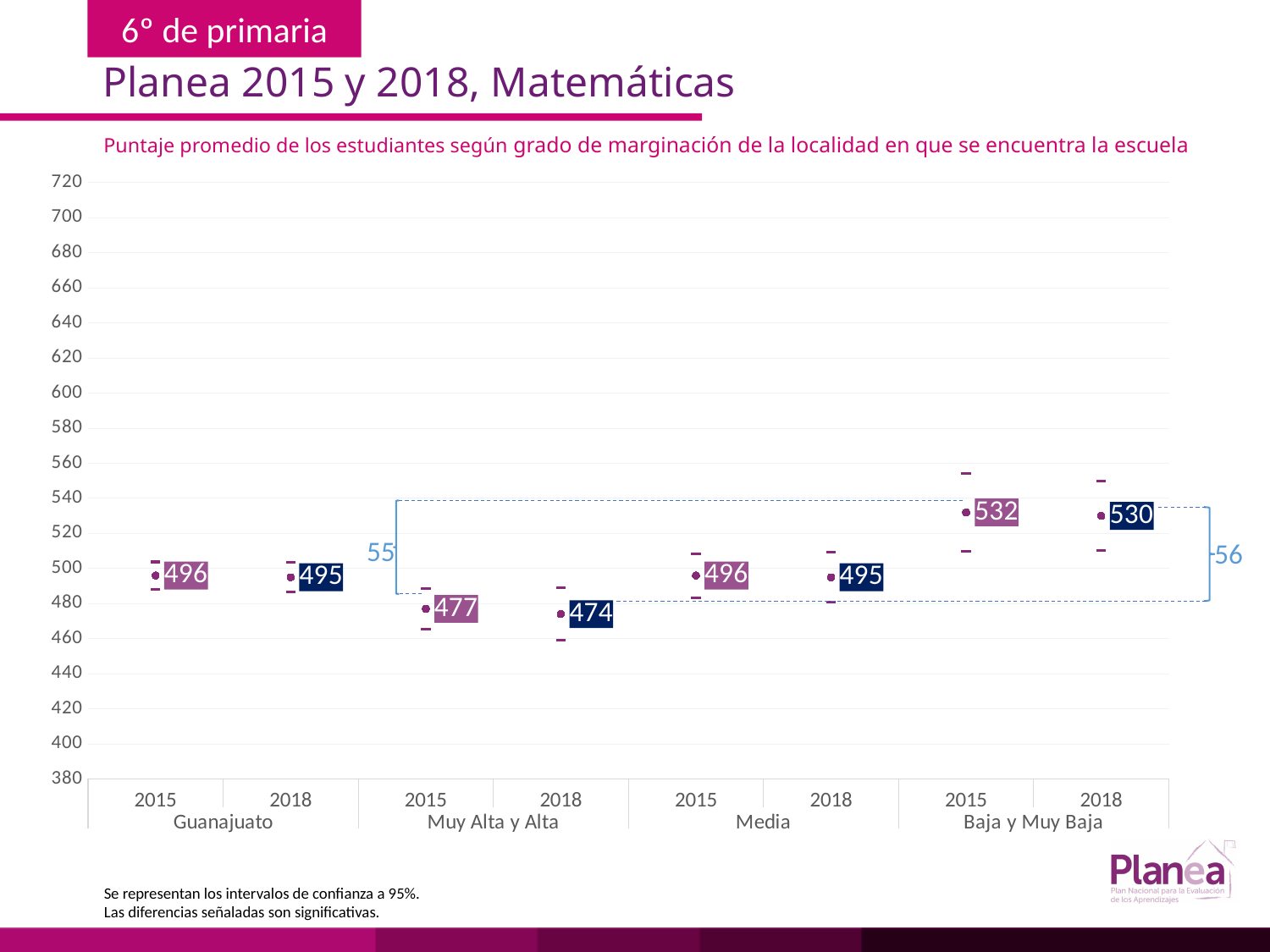
Is the 2018 score for Baja y Muy Baja greater or less than 520? greater What is the 2018 average score for the Muy Alta y Alta marginación group? 474 What does the note below the chart say the bars around each point represent? Intervalos de confianza a 95% Which group and year has the lowest average score? Muy Alta y Alta, 2018 What is the 2015 average score for the Baja y Muy Baja group? 532 What is the 2015 average score for Guanajuato? 496 Which group and year has the highest average score? Baja y Muy Baja, 2015 Which is larger, the 2015 score for Media or the 2015 score for Muy Alta y Alta? Media What is the difference between the 2018 scores of Baja y Muy Baja and Muy Alta y Alta? 56 How many marginación groups (including Guanajuato) are shown on the x axis? 4 What is the 2018 average score for the Media group? 495 What is the difference between the 2015 scores of Baja y Muy Baja and Muy Alta y Alta? 55